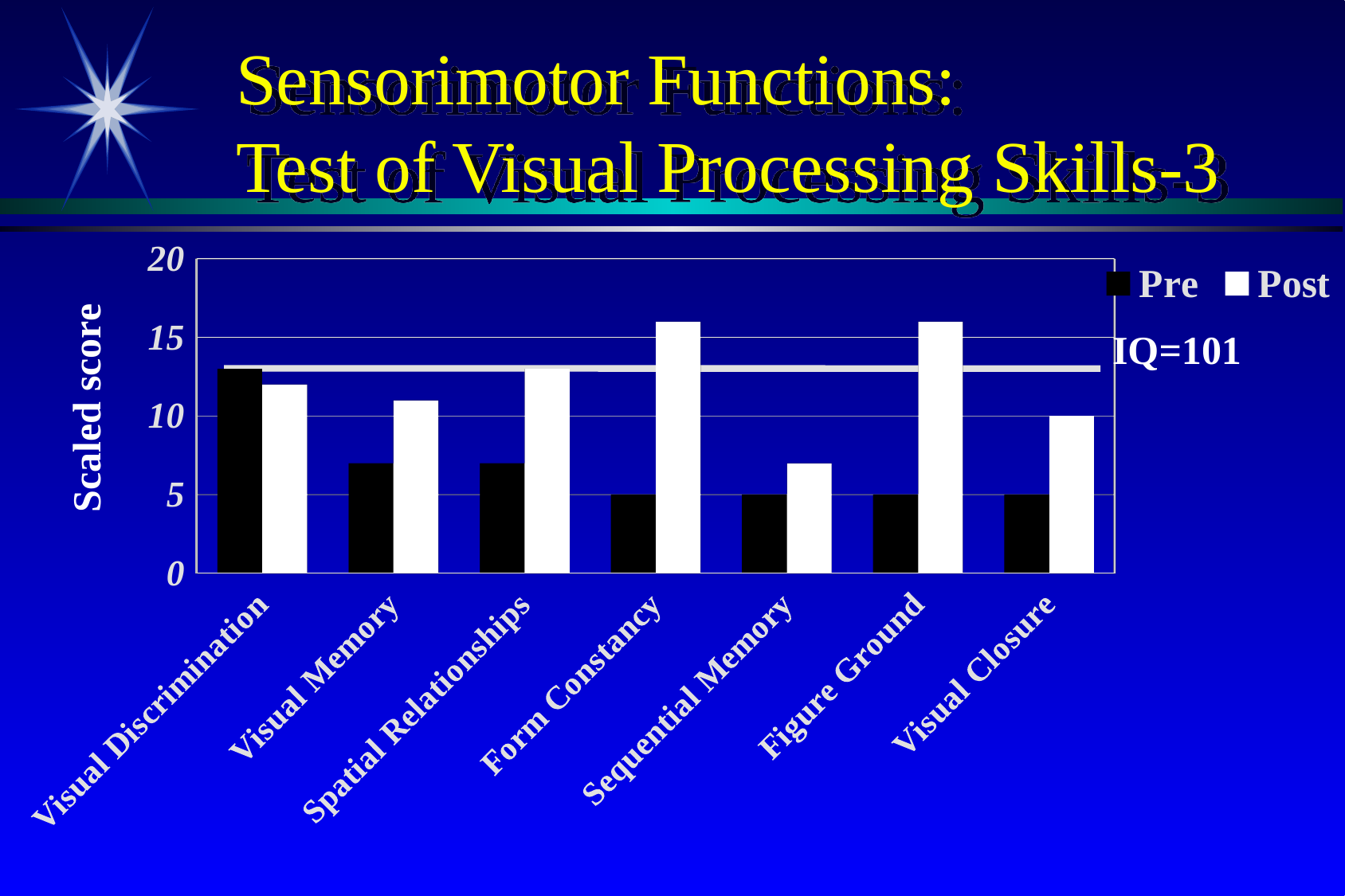
Which category has the lowest Post scaled score? Sequential Memory How many categories are shown on the x axis? 7 For Spatial Relationships, which is larger, the Pre or the Post score? Post Is the Post value for Form Constancy greater or less than 15? greater How many series does the legend list? 2 What is the Post scaled score for Visual Closure? 10 What kind of chart is shown on the slide? bar chart What is the Pre scaled score for Form Constancy? 5 What is the label of the y axis? Scaled score Which category has the highest Pre scaled score? Visual Discrimination Is the Pre value for Visual Memory greater or less than 10? less Is the Post value for Sequential Memory greater or less than 10? less